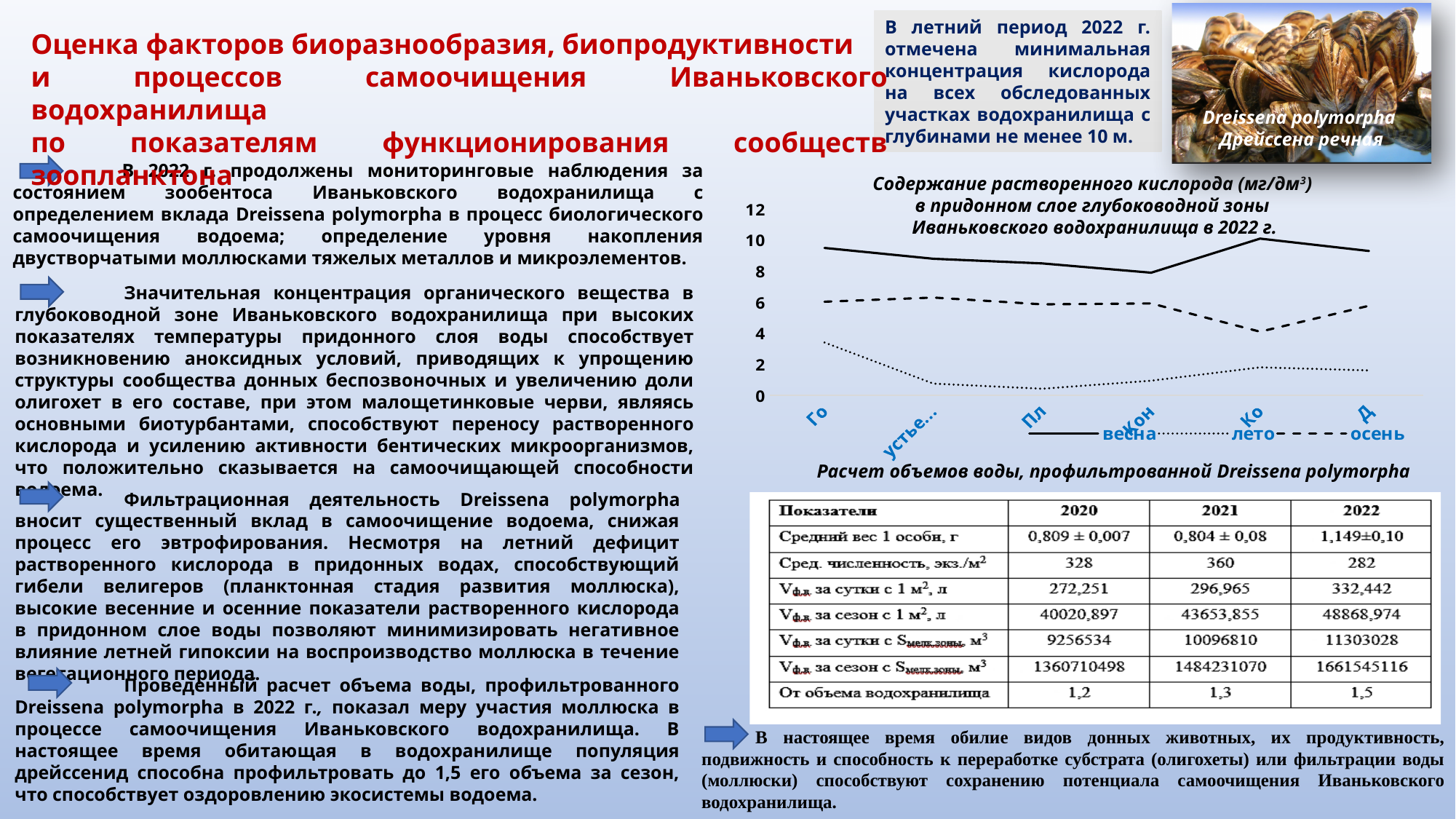
At the first point on the x axis, which is larger: the value for весна or the value for лето? весна At the first point on the x axis, is the value for весна greater or less than 8? greater Which series in the dissolved oxygen chart has the highest values across all points? весна How many points along the x axis does each series of the dissolved oxygen chart have? 6 What kind of chart is shown on the slide? line chart At the fifth point on the x axis, is the value for осень greater or less than 6? less Which series are listed in the legend of the dissolved oxygen chart? весна, лето, осень How many series does the legend of the dissolved oxygen chart list? 3 Does the лето series rise or fall from the first point to the second point on the x axis? fall At the first point on the x axis, is the value for лето greater or less than 6? less Which series in the dissolved oxygen chart has the lowest values across all points? лето